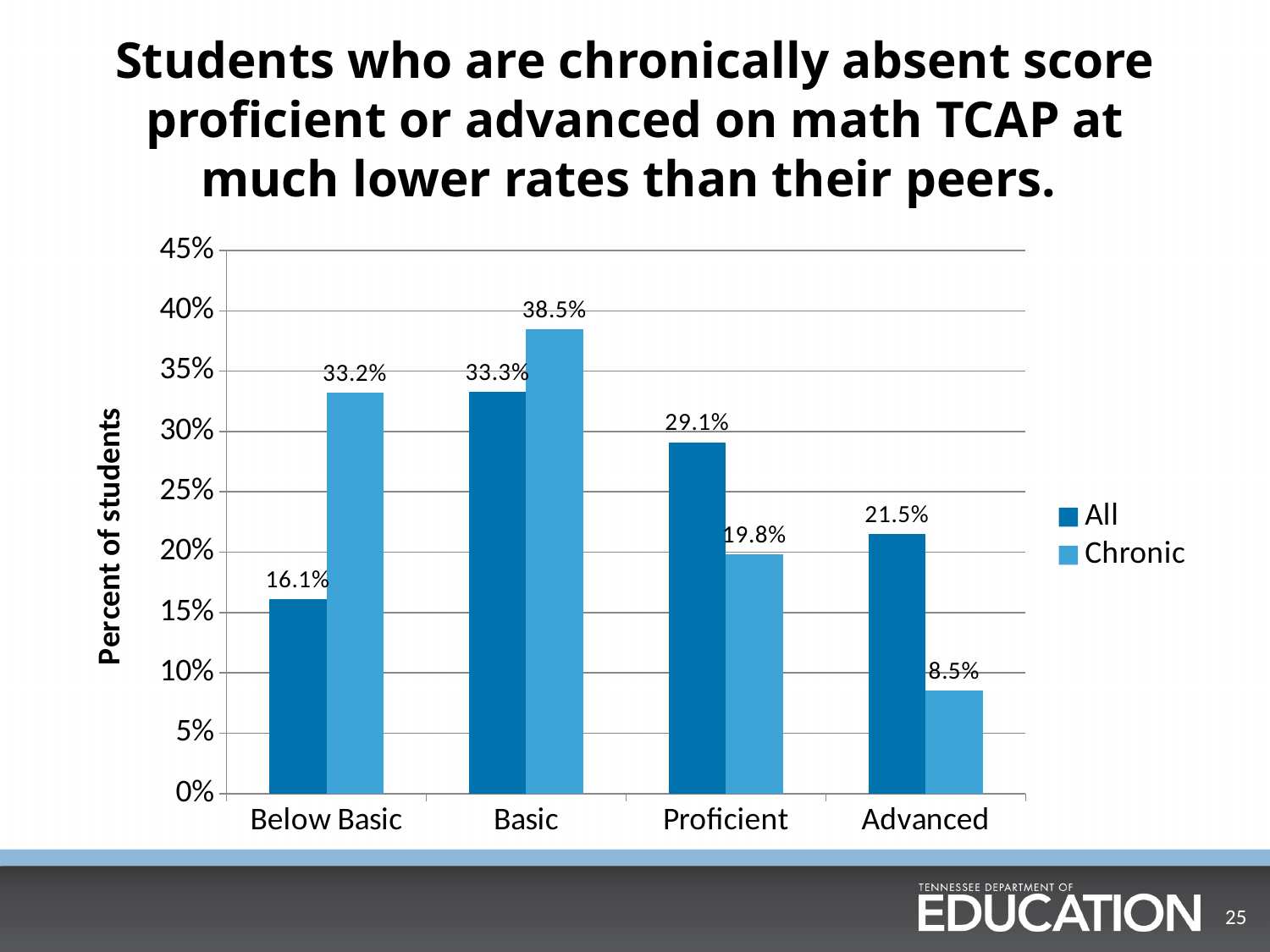
What percent of all students scored Below Basic? 16.1% In the Proficient category, which series has the larger value, All or Chronic? All Which category has the lowest value for the Chronic series? Advanced What is the value for the Chronic series in the Basic category? 38.5% What is the label of the vertical axis? Percent of students What is the difference between the All and Chronic values in the Advanced category? 13.0% What percent of chronically absent students scored Advanced? 8.5% What kind of chart is shown on the slide? Bar chart How many series does the legend list? 2 What is the difference between the Chronic and All values in the Below Basic category? 17.1% Which category has the highest value for the All series? Basic How many categories are shown on the x axis? 4